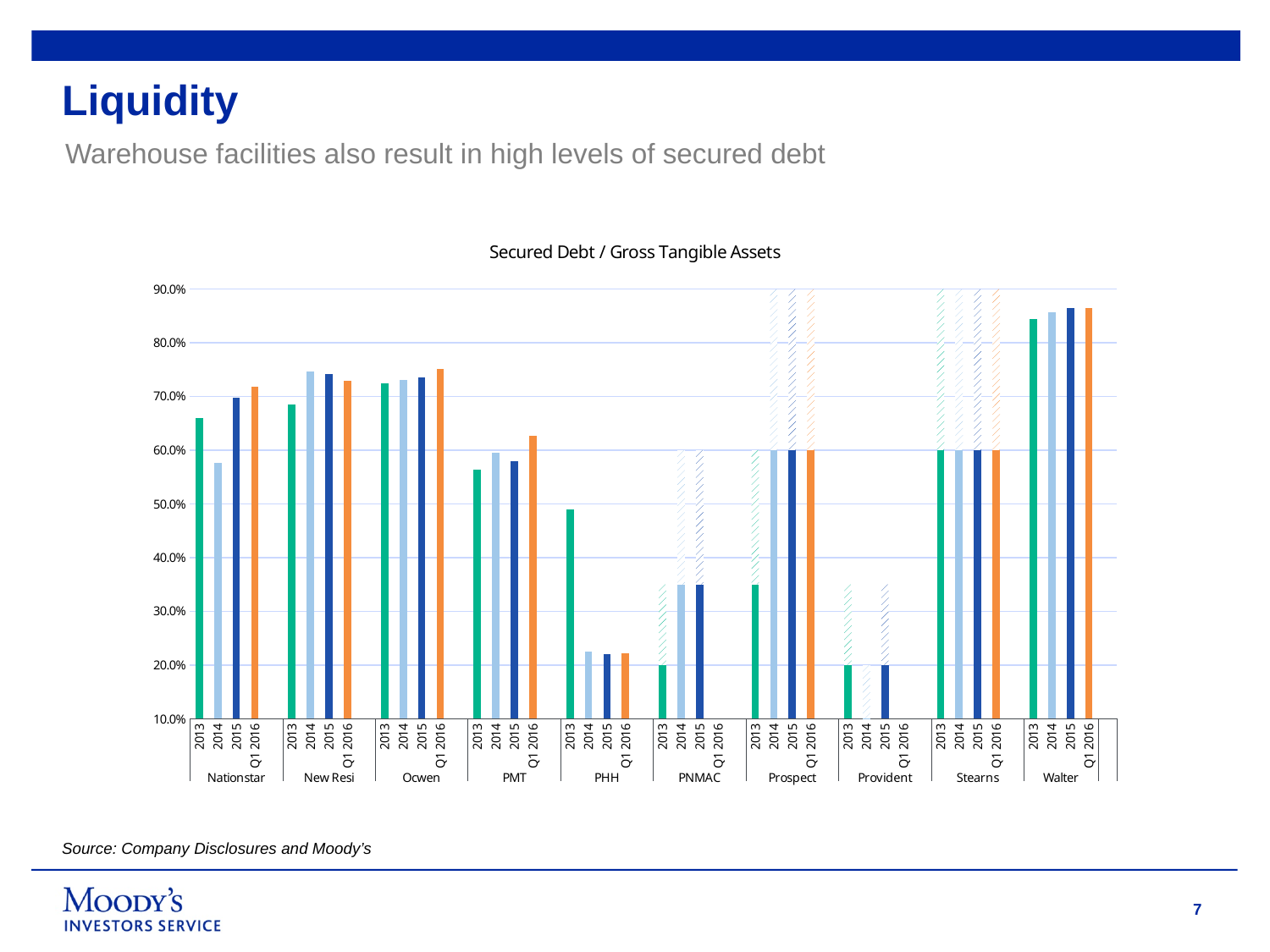
Is the value for PMT in Q1 2016 greater or less than 60.0%? greater How many time periods are plotted for each company in the chart? 4 What is the title of the chart? Secured Debt / Gross Tangible Assets For Nationstar, which is larger: the value for 2014 or the value for 2015? 2015 Do the values for Ocwen rise or fall from 2013 to Q1 2016? rise Is the value for PHH in 2014 greater or less than 30.0%? less Which company has the tallest bars in the chart? Walter Is the value for Walter in 2013 greater or less than 80.0%? greater What kind of chart is shown on the slide? bar chart For PHH, which is larger: the value for 2013 or the value for 2014? 2013 How many companies are shown along the x axis of the chart? 10